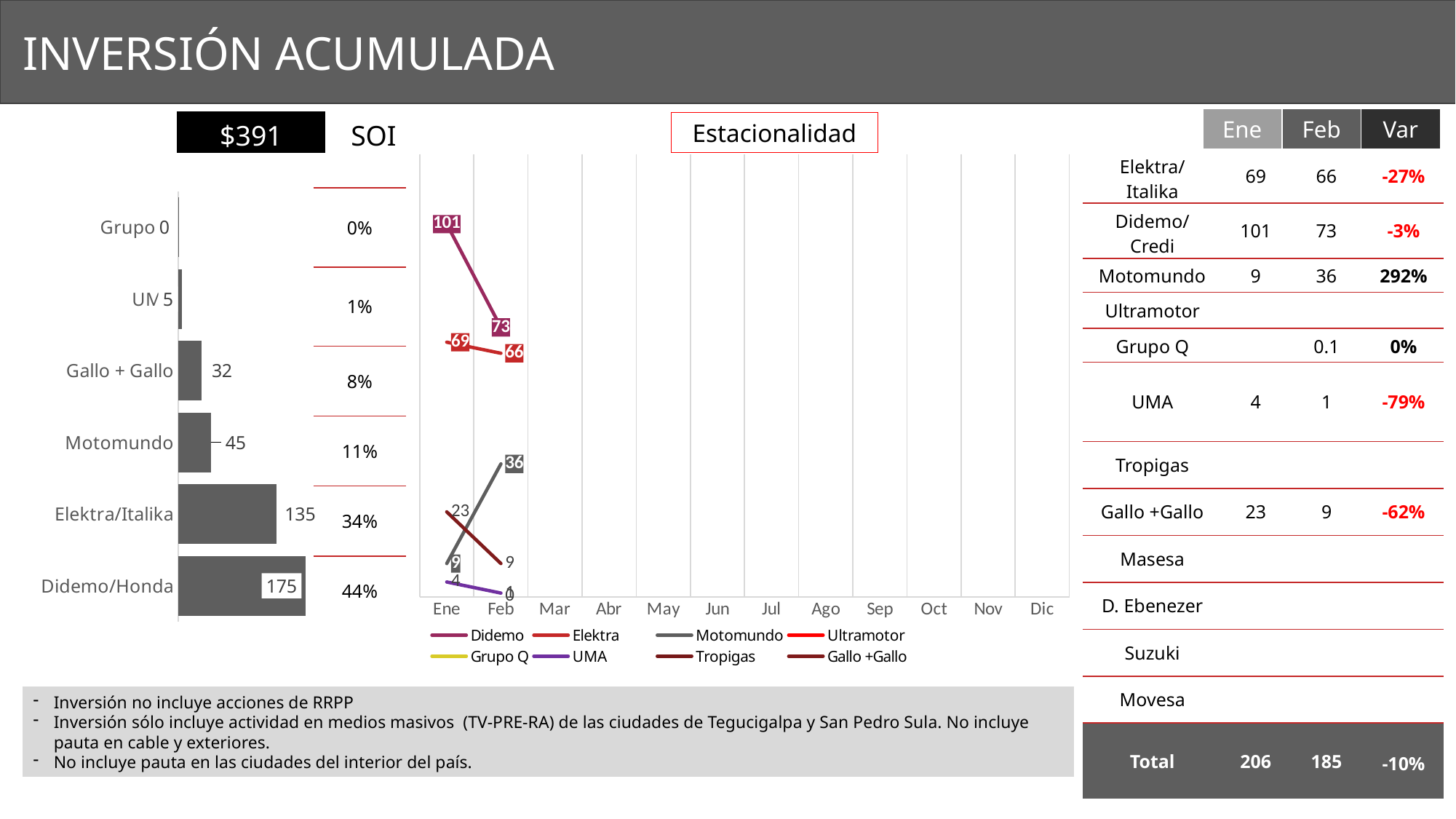
In the left bar chart, what is the value for Elektra/Italika? 135 In the left bar chart, what is the difference between the values for Didemo/Honda and Elektra/Italika? 40 In the Estacionalidad chart, how many months are shown on the x axis? 12 In the Estacionalidad chart, how many series does the legend list? 8 In the left bar chart, which is larger, the value for Motomundo or the value for Gallo + Gallo? Motomundo In the left bar chart, what is the value for Didemo/Honda? 175 In the Estacionalidad chart, what is the value for Didemo in Ene? 101 In the Estacionalidad chart, does the Didemo line rise or fall from Ene to Feb? fall In the left bar chart, what is the value for Gallo + Gallo? 32 In the left bar chart, which category has the highest value? Didemo/Honda What kind of chart is the left chart? bar chart In the Estacionalidad chart, what is the value for Motomundo in Feb? 36